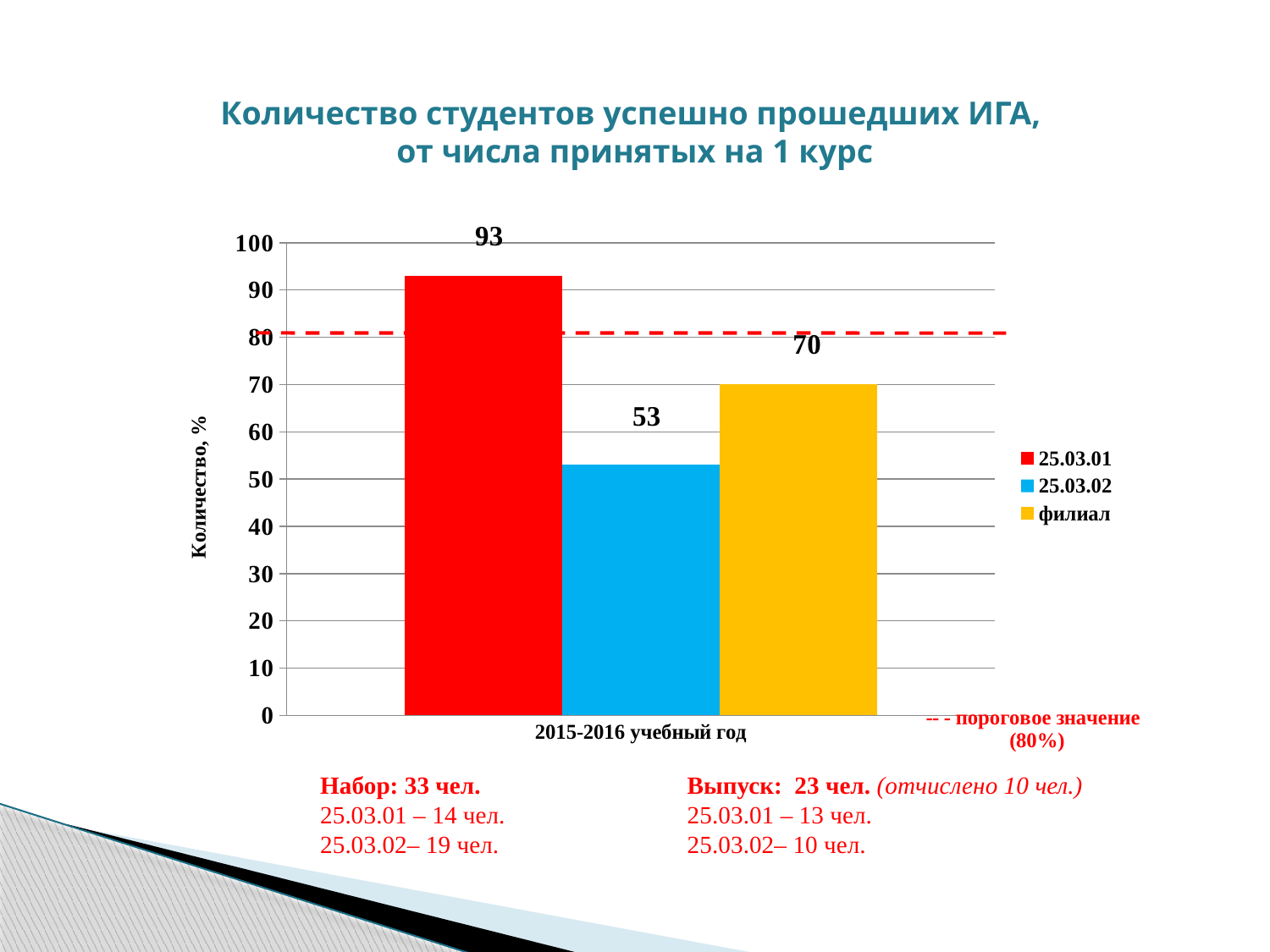
Which is larger, the value for филиал or the value for 25.03.02? филиал How many series does the legend list? 3 What is the difference between the values for филиал and 25.03.02? 17 What is the value for series 25.03.01 in the chart? 93 What is the value for the филиал series in the chart? 70 What is the value for series 25.03.02 in the chart? 53 Which series has the lowest value in the chart? 25.03.02 Which series has the highest value in the chart? 25.03.01 Is the value for 25.03.02 greater or less than 60? less What kind of chart is shown on the slide? bar chart What threshold value does the red dashed line represent? 80% What is the difference between the values for 25.03.01 and 25.03.02? 40